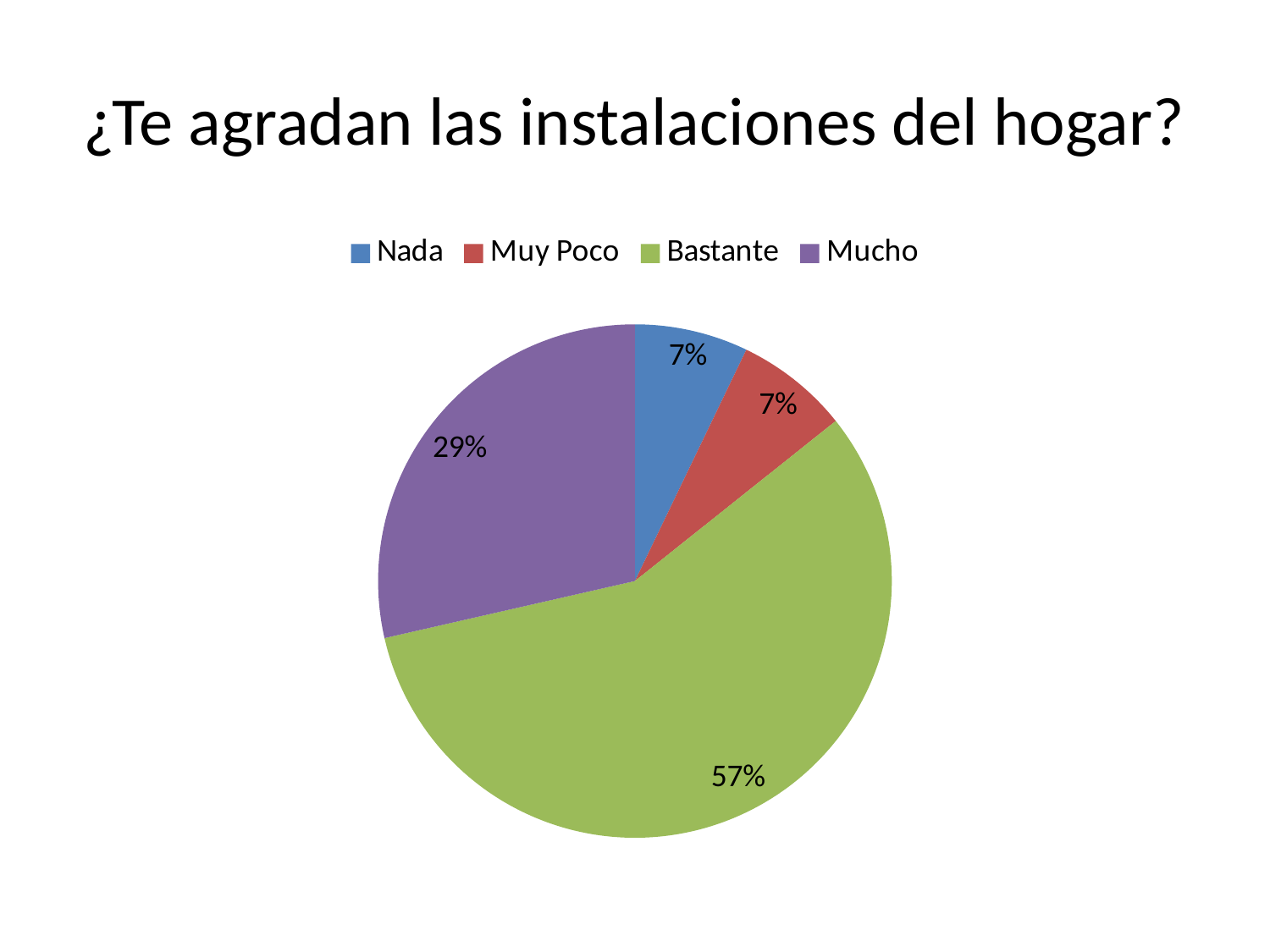
What is the combined share of Nada and Muy Poco? 14% How many categories does the legend list? 4 What share of the pie does Mucho have? 29% What share of the pie does Nada have? 7% What kind of chart is shown on the slide? pie chart What colour is the Bastante slice? green Which is larger, the share for Mucho or the share for Nada? Mucho What is the title of the chart? ¿Te agradan las instalaciones del hogar? Which category has the largest slice of the pie? Bastante What share of the pie does Bastante have? 57% What is the difference between the shares of Bastante and Mucho? 28%